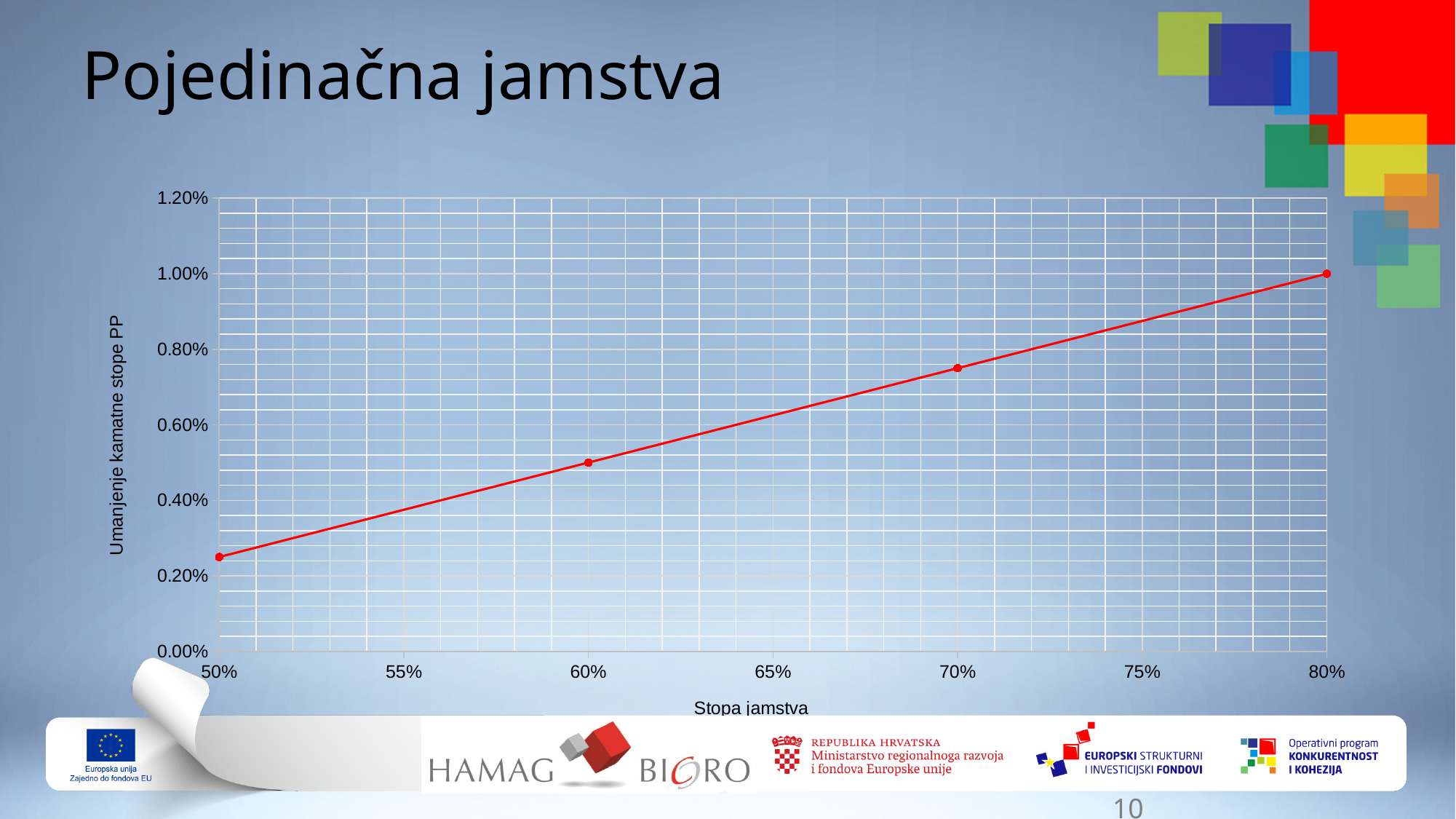
Do the values rise or fall as the Stopa jamstva increases from 50% to 80%? rise At which Stopa jamstva is the Umanjenje kamatne stope PP highest? 80% What is the title of the horizontal axis? Stopa jamstva Is the value at a Stopa jamstva of 70% greater or less than 0.60%? greater Is the value at a Stopa jamstva of 50% greater or less than 0.40%? less What kind of chart is shown on the slide? line chart What is the title of the vertical axis? Umanjenje kamatne stope PP Which has the larger Umanjenje kamatne stope PP value: a Stopa jamstva of 60% or 70%? 70% At which Stopa jamstva is the Umanjenje kamatne stope PP lowest? 50% Is the value at a Stopa jamstva of 60% greater or less than 0.40%? greater How many data points are plotted on the line? 4 What is the Umanjenje kamatne stope PP value at a Stopa jamstva of 80%? 1.00%